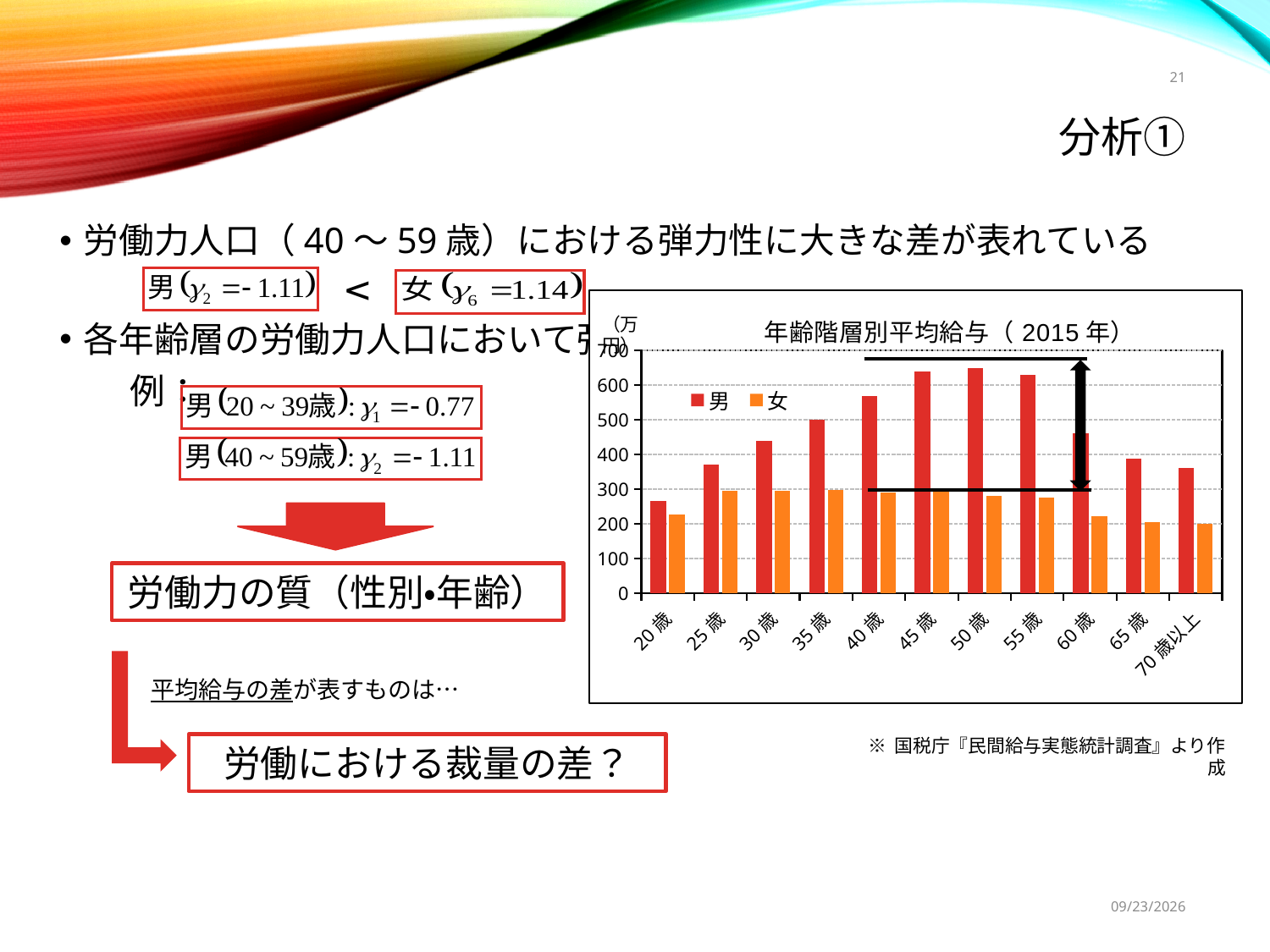
How many series does the chart legend list? 2 What is the title of the chart? 年齢階層別平均給与（2015年） At 50歳, which series has the larger value, 男 or 女? 男 Is the value for 男 at 70歳以上 greater or less than 300? greater Do the values for 男 rise or fall from 20歳 to 50歳? rise How many age categories are shown on the x axis of the chart? 11 Which series is drawn in orange in the chart? 女 For 女, which is larger, the value at 20歳 or the value at 25歳? 25歳 What kind of chart is shown on the slide? bar chart Is the value for 女 at 60歳 greater or less than 300? less Is the value for 男 at 40歳 greater or less than 500? greater Which age category has the lowest value for 男? 20歳